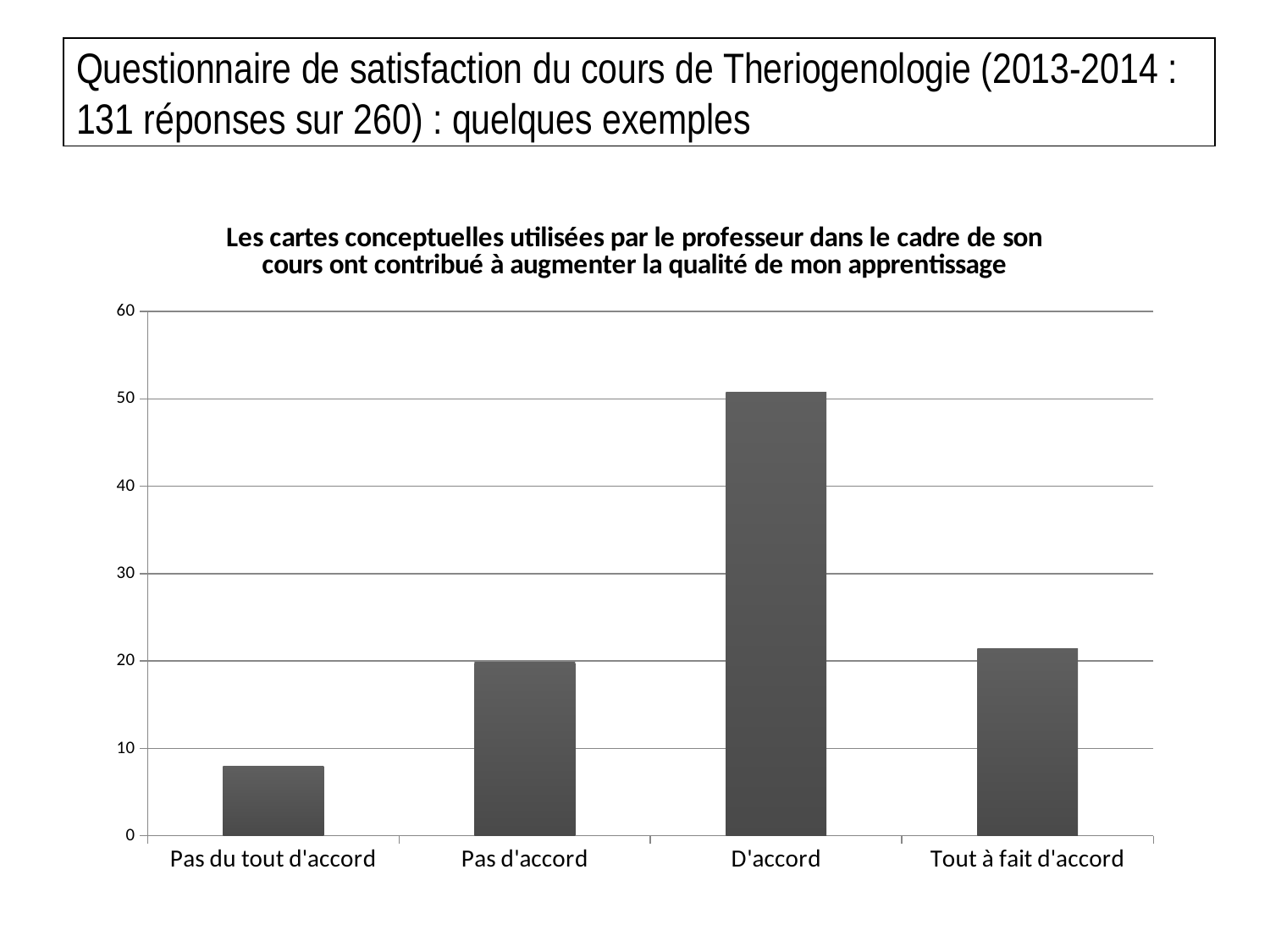
Is the value for D'accord greater or less than 40? greater What kind of chart is shown on the slide? bar chart Is the value for Pas du tout d'accord greater or less than 10? less Which category has the lowest bar? Pas du tout d'accord Is the value for Tout à fait d'accord greater or less than 30? less How many categories are shown on the x axis of the chart? 4 What is the highest value shown on the y axis of the chart? 60 Which is larger, the value for Tout à fait d'accord or the value for Pas du tout d'accord? Tout à fait d'accord What is the title of the chart? Les cartes conceptuelles utilisées par le professeur dans le cadre de son cours ont contribué à augmenter la qualité de mon apprentissage Which category has the highest bar? D'accord Which is larger, the value for D'accord or the value for Pas d'accord? D'accord